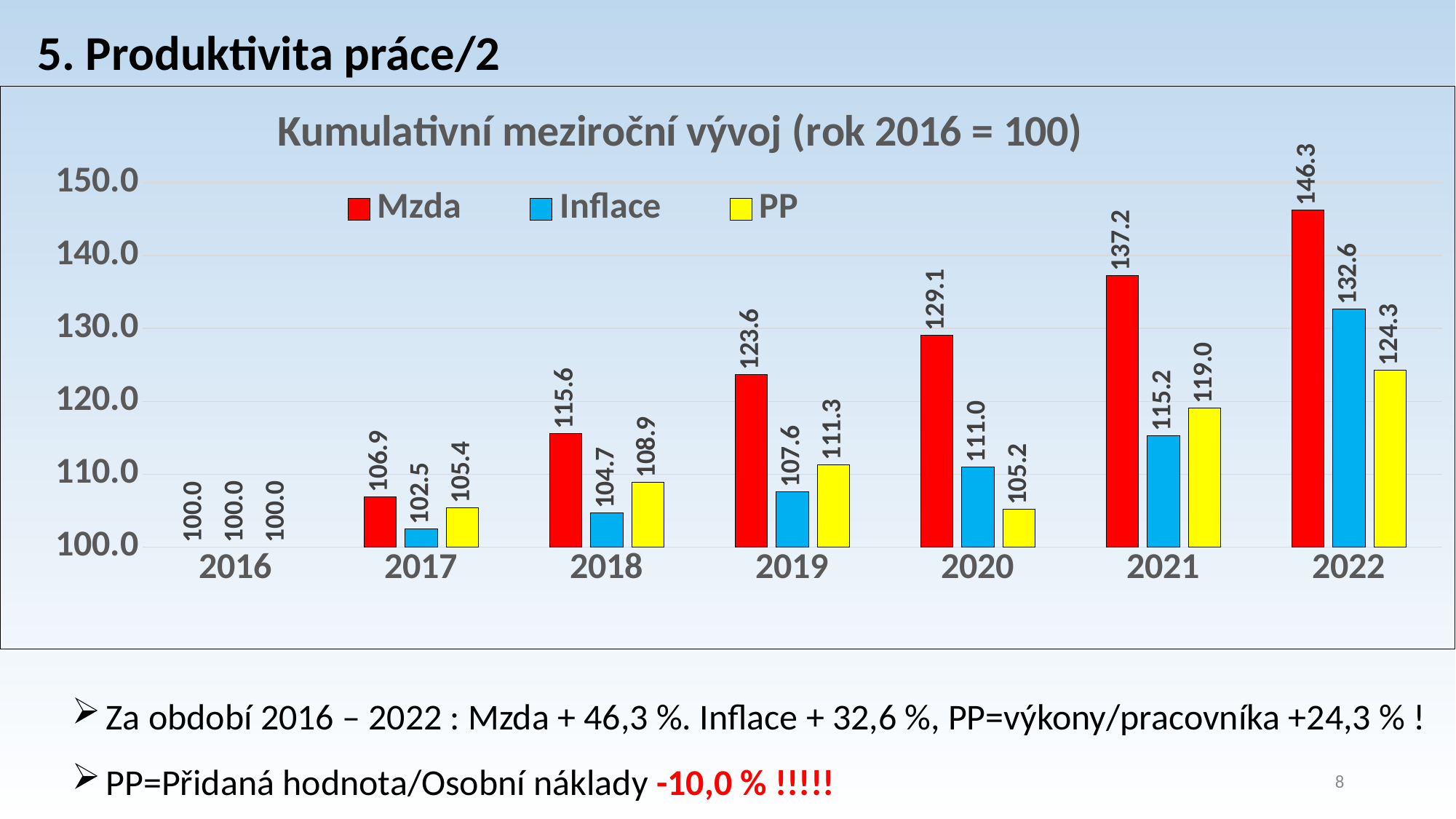
In which year after 2016 is the PP series lowest? 2020 What is the value of Inflace in 2019? 107.6 What is the value of PP in 2021? 119.0 In which year is the Mzda series highest? 2022 Does the Mzda series rise or fall from 2016 to 2022? rise What is the difference between Mzda and PP in 2022? 22.0 What is the value of Mzda in 2022? 146.3 How many series does the legend list? 3 Is the value of Inflace in 2021 greater or less than 120.0? less Which is larger in 2020, Inflace or PP? Inflace What kind of chart is shown? bar chart How many years are shown on the x axis? 7